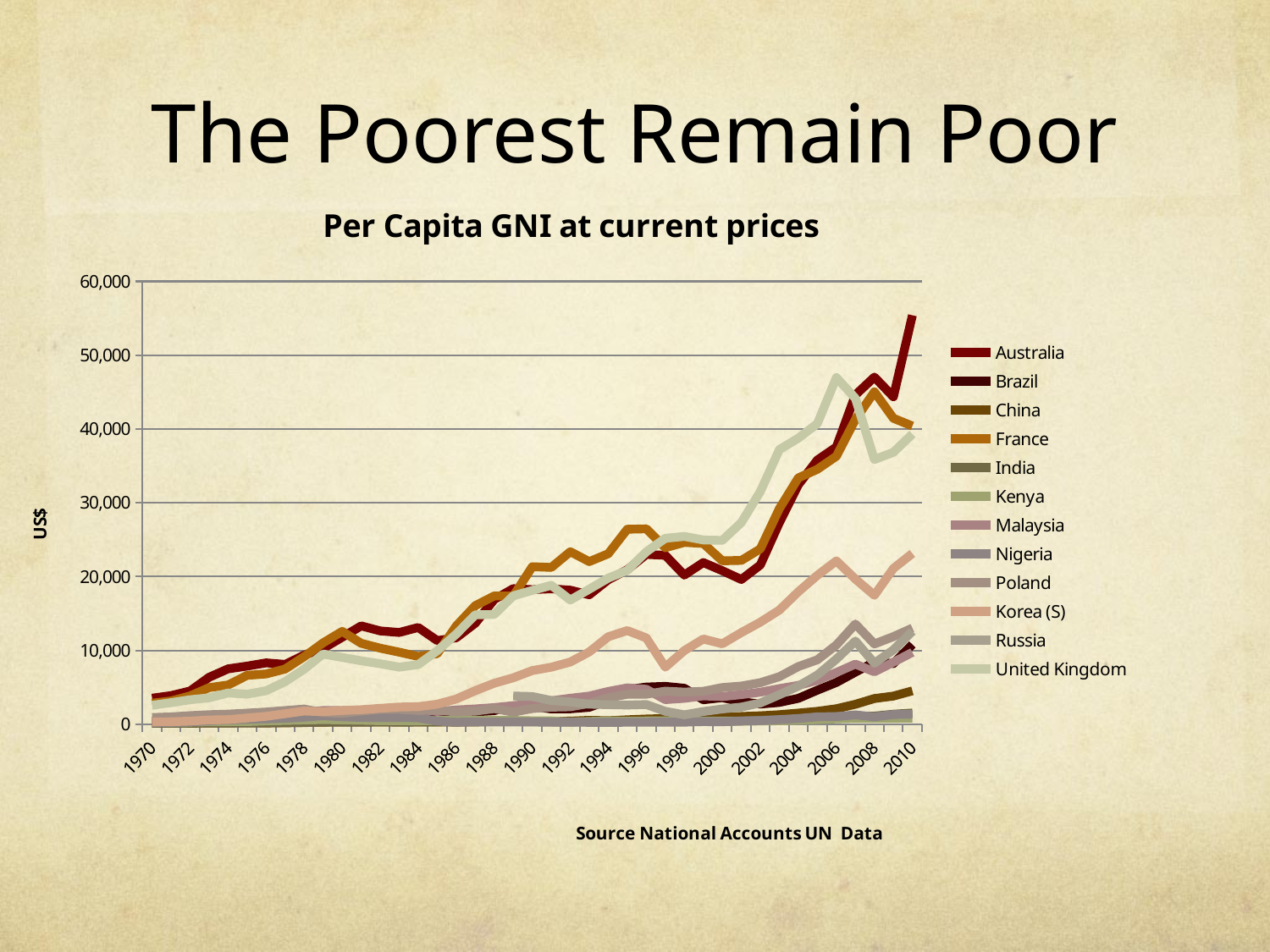
Is the value for Kenya in 2010 greater or less than 10,000? less What is the title of the chart? Per Capita GNI at current prices Is the value for Korea (S) in 2010 greater or less than 20,000? greater What kind of chart is shown on the slide? line chart In 2010, which is larger: the value for Korea (S) or the value for Kenya? Korea (S) Does the value for Australia generally rise or fall from 1970 to 2010? rise Is the value for Australia in 2010 greater or less than 50,000? greater What is the label on the vertical axis of the chart? US$ How many series does the legend list? 12 Which series has the highest value in 2010? Australia